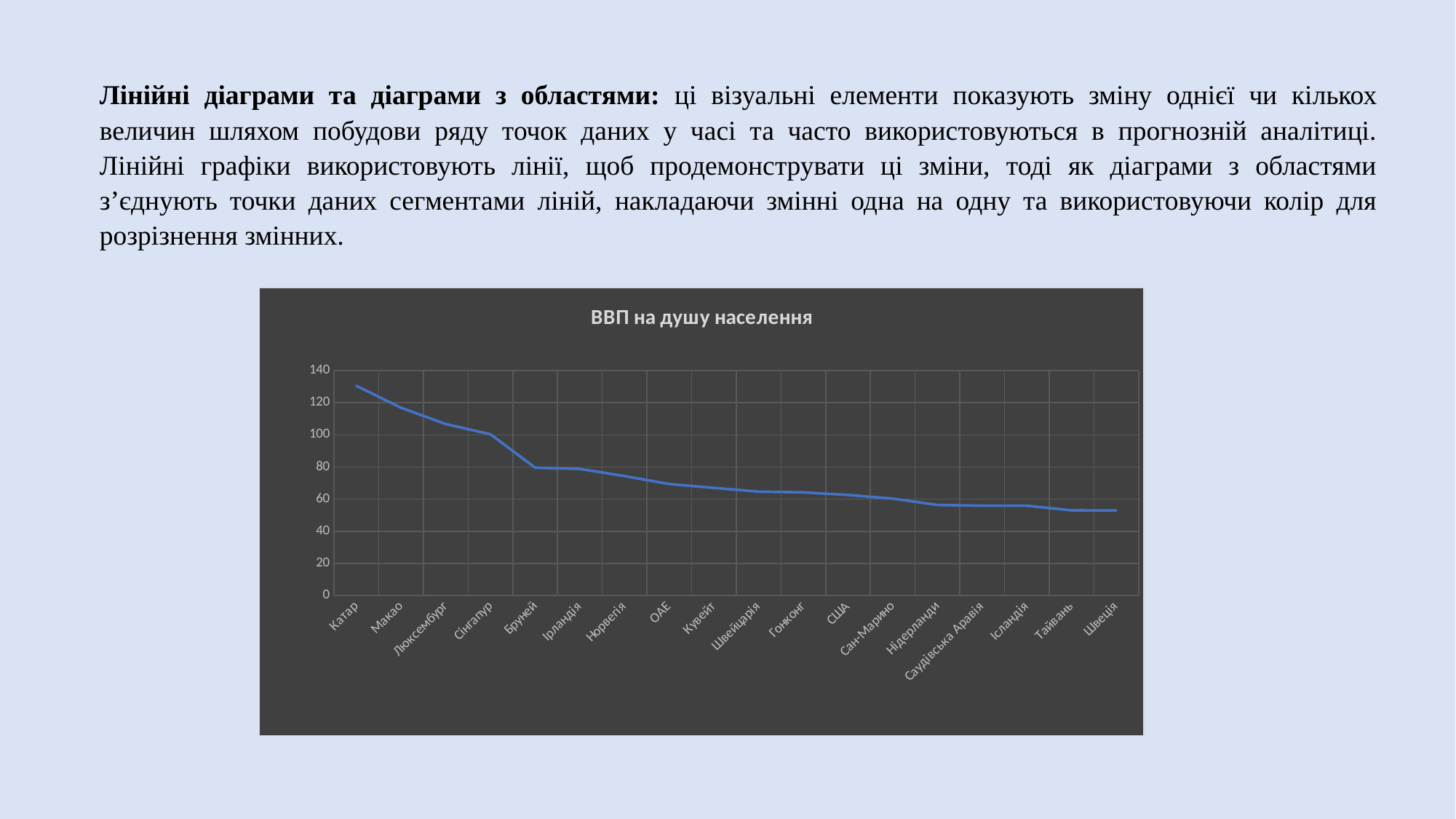
What kind of chart is shown on the slide? line chart Which country has the highest value in the chart? Катар Is the value for Бруней greater or less than 100? less Is the value for Макао greater or less than 100? greater What is the title of the chart? ВВП на душу населення Which has the larger value, Люксембург or Бруней? Люксембург Is the value for Катар greater or less than 120? greater How many countries are plotted on the x axis of the chart? 18 Do the values rise or fall moving from left to right along the x axis? fall Which country is plotted first on the x axis? Катар